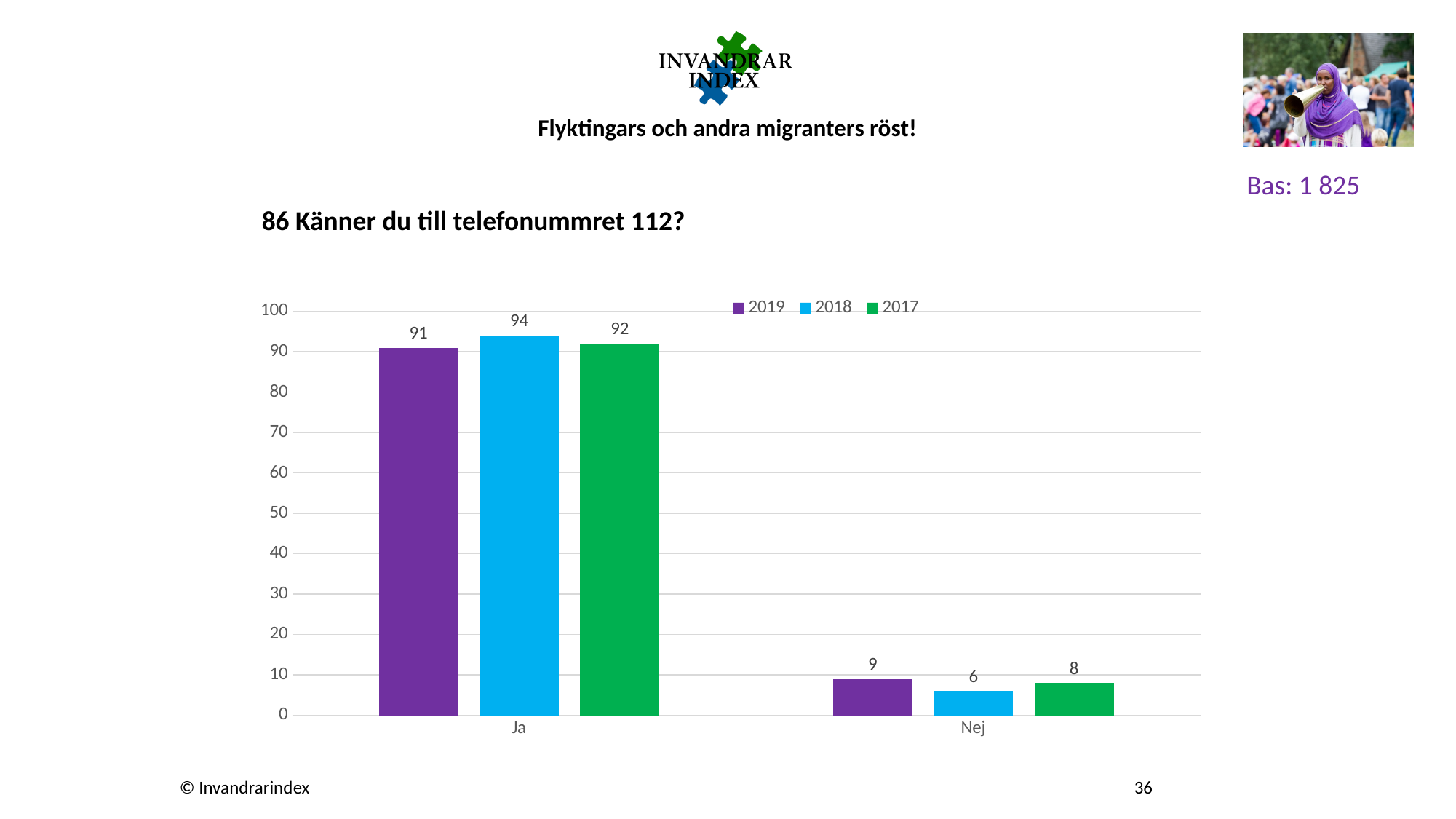
What is the value for 2018 in the Nej category? 6 What is the value for 2017 in the Ja category? 92 Is the value for 2017 in the Nej category greater or less than 10? less Which year has the lowest value in the Nej category? 2018 What is the title of the chart? 86 Känner du till telefonummret 112? How many categories are shown on the x axis? 2 What is the value for 2019 in the Ja category? 91 How many series does the legend list? 3 Which year has the highest value in the Ja category? 2018 What is the difference between the 2018 and 2019 values in the Ja category? 3 What kind of chart is shown on the slide? bar chart Which is larger: the 2019 value for Nej or the 2017 value for Nej? 2019